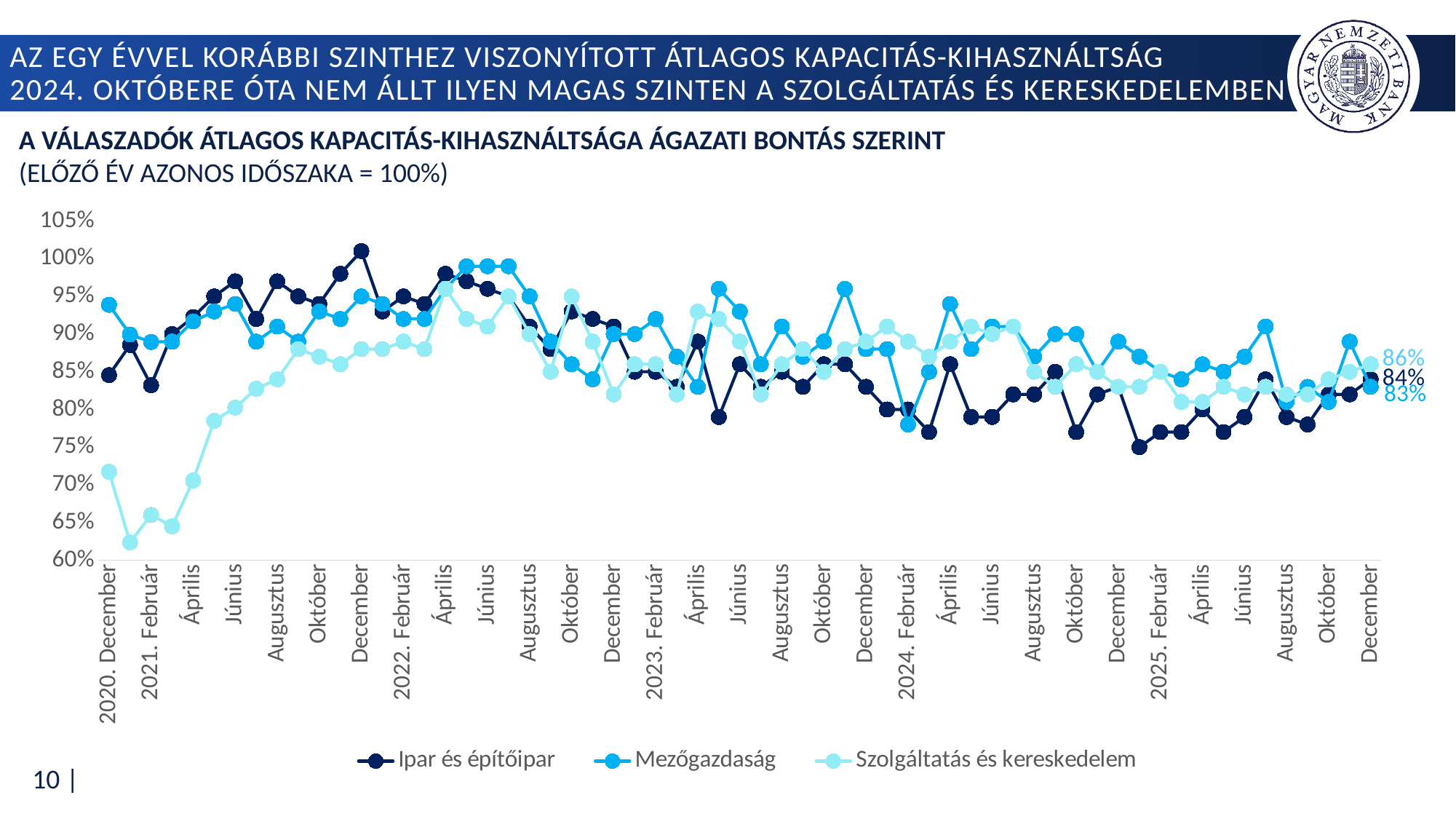
What is the difference between the Szolgáltatás és kereskedelem and Mezőgazdaság values at the last point (December 2025)? 3 percentage points Which series has the lowest value at 2020. December? Szolgáltatás és kereskedelem Is the value for Ipar és építőipar in December 2021 greater or less than 95%? greater What is the value for Ipar és építőipar at the last point (December 2025)? 84% At the last point (December 2025), which is larger: Ipar és építőipar or Mezőgazdaság? Ipar és építőipar How many series does the legend list? 3 Does the Szolgáltatás és kereskedelem line rise or fall between 2021. Február and Június 2021? rise Which series has the highest value at the last point (December 2025)? Szolgáltatás és kereskedelem What kind of chart is shown on the slide? line chart What is the value for Mezőgazdaság at the last point (December 2025)? 83% What is the value for Szolgáltatás és kereskedelem at the last point (December 2025)? 86%